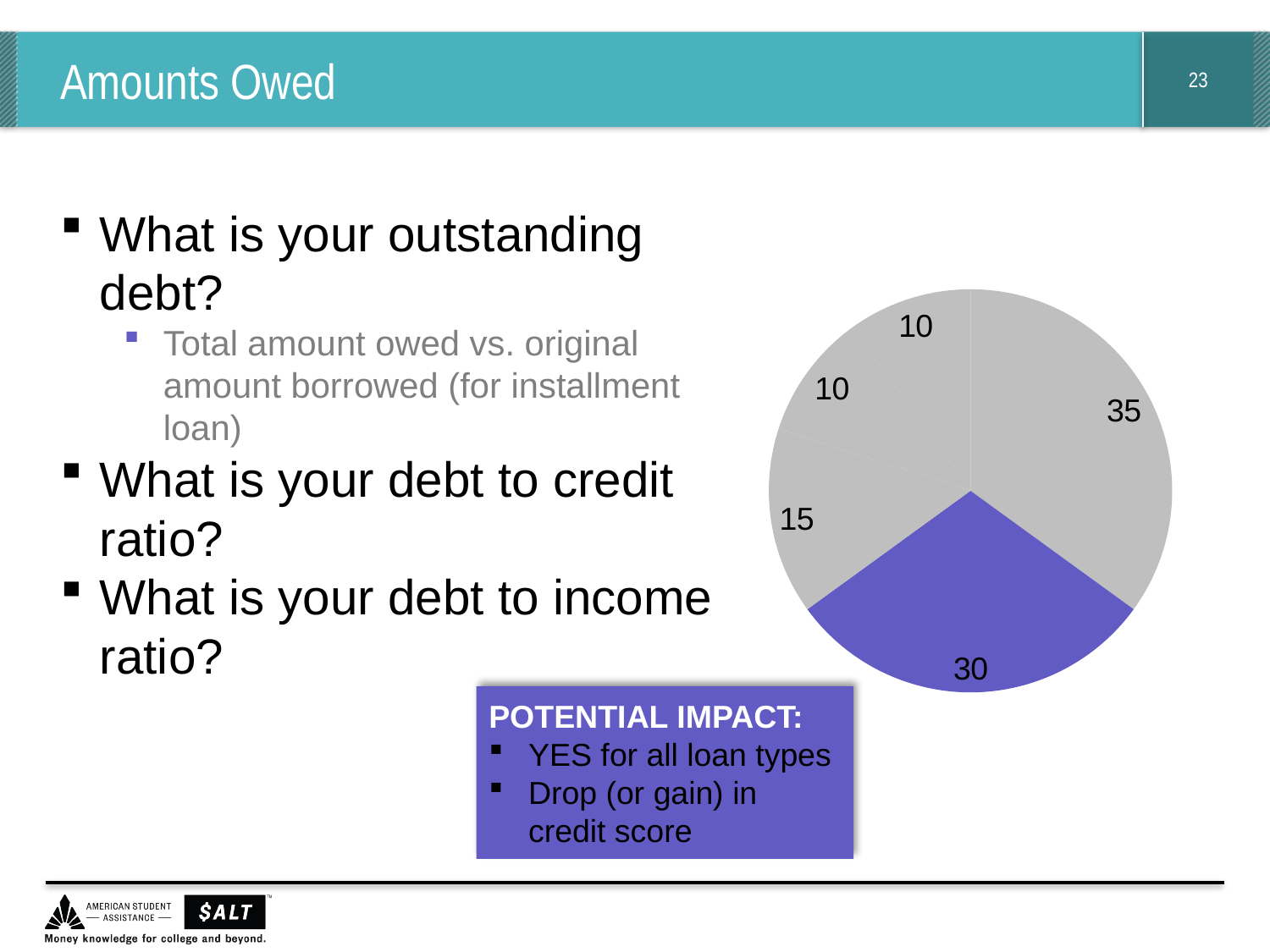
What is the total of all the slice values in the pie chart? 100 What kind of chart is shown on the slide? pie chart How many slices does the pie chart have? 5 What colour is the slice labelled 30 in the pie chart? purple What is the value of the smallest slice in the pie chart? 10 What share of the pie does the purple slice (30) represent? 30% What is the difference between the largest slice (35) and the purple slice (30)? 5 What value is labelled on the purple slice of the pie chart? 30 Which is larger: the slice labelled 35 or the slice labelled 15? 35 What is the value of the largest slice in the pie chart? 35 How many slices in the pie chart are labelled 10? 2 How many slices of the pie chart are grey? 4